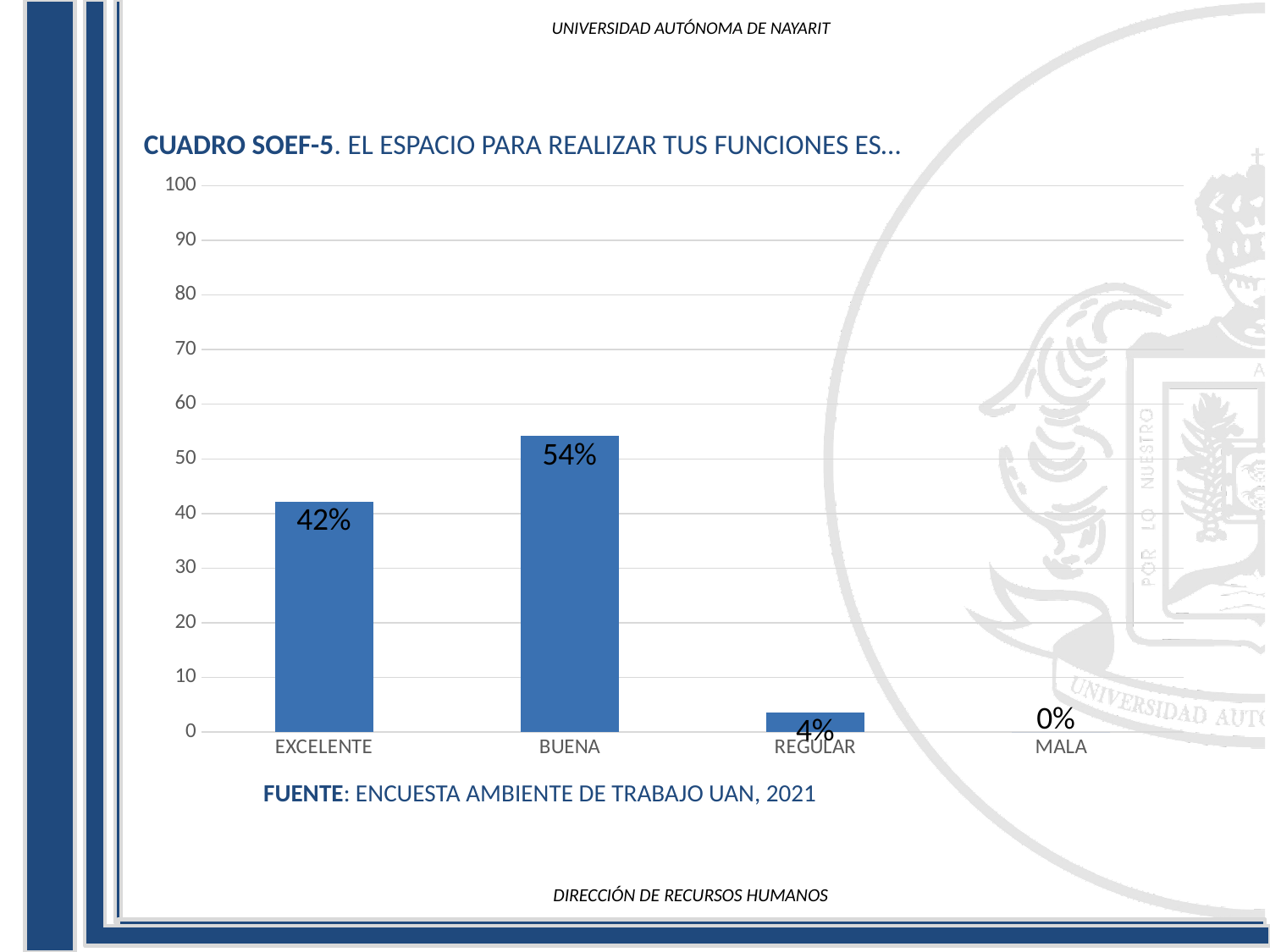
Which category has the highest value? BUENA Which is larger, the value for EXCELENTE or the value for REGULAR? EXCELENTE What is the value for REGULAR? 4% What is the value for BUENA? 54% What kind of chart is shown on the slide? bar chart What is the value for MALA? 0% What is the difference between the values for BUENA and EXCELENTE? 12% Is the value for BUENA greater or less than 50? greater How many categories are shown on the x axis? 4 Which category has the lowest value? MALA What is the value for EXCELENTE? 42% What is the title of the chart? CUADRO SOEF-5. EL ESPACIO PARA REALIZAR TUS FUNCIONES ES…